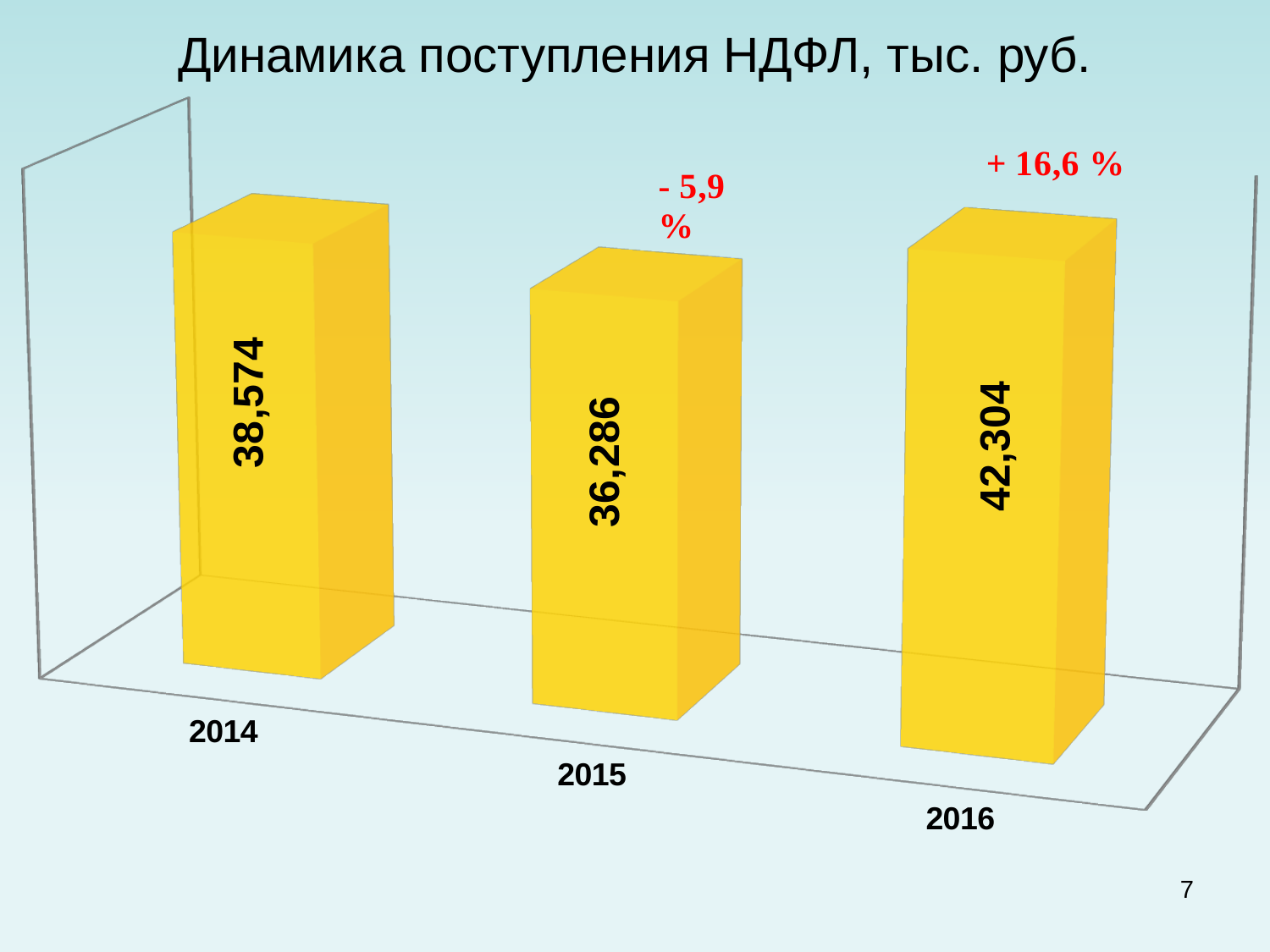
What is the value for 2015? 36,286 How many years are shown on the chart? 3 What is the difference between the values for 2016 and 2015? 6,018 Which year has the lowest value? 2015 Which year has the highest value? 2016 What is the value for 2014? 38,574 What is the title of the chart? Динамика поступления НДФЛ, тыс. руб. What is the value for 2016? 42,304 What is the difference between the values for 2014 and 2015? 2,288 What percentage change is annotated above the 2016 bar? + 16,6 % Which is larger, the value for 2014 or the value for 2016? 2016 What kind of chart is shown on the slide? Bar chart